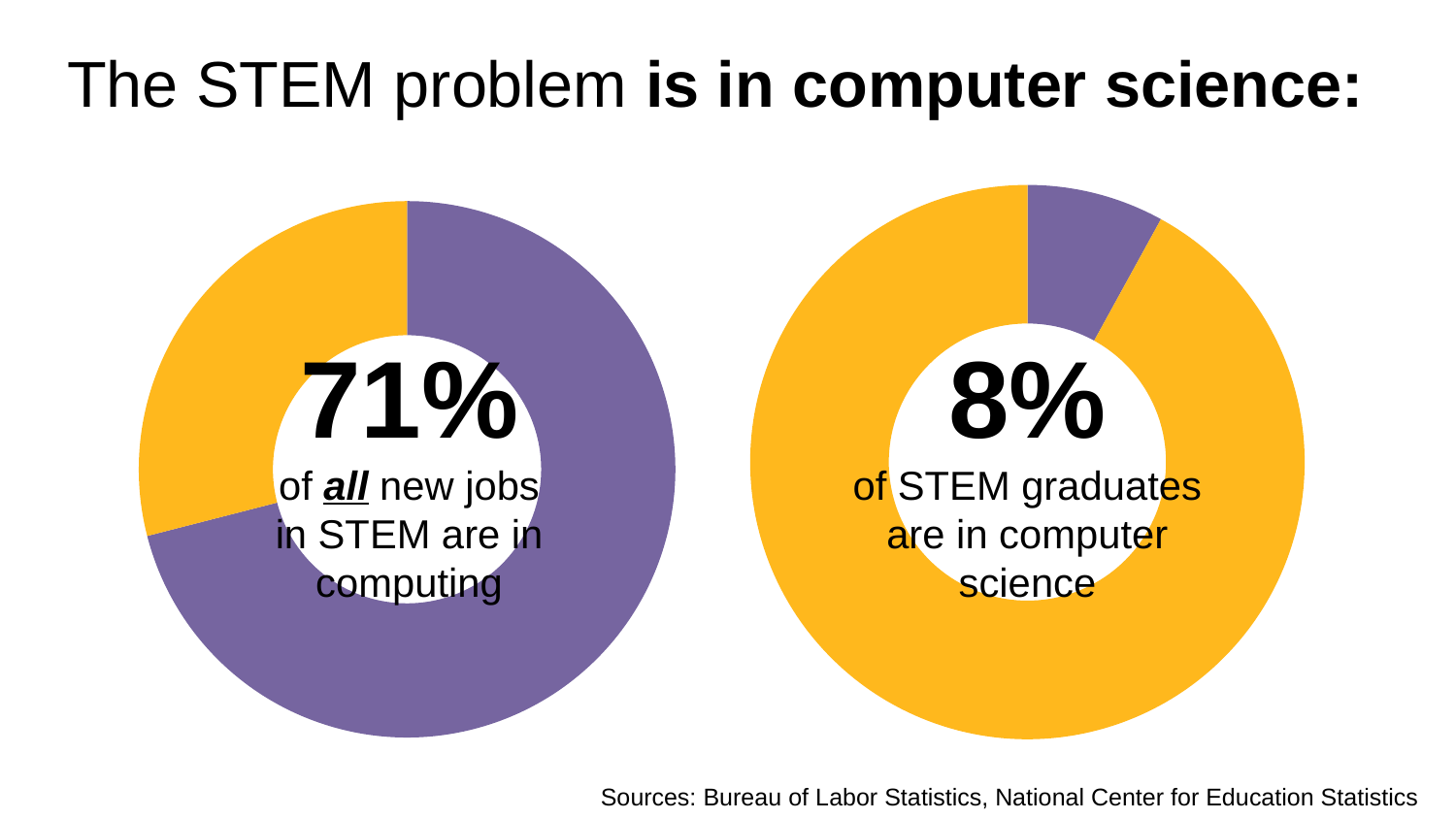
What kind of chart is used on the right side of the slide? Donut (pie) chart What is the difference in percentage points between the 71% in the left chart and the 8% in the right chart? 63 percentage points In the right chart, what percentage of STEM graduates are in computer science? 8% In the right chart, is the highlighted purple slice greater or less than 25% of the donut? less In the left chart, what percentage of all new jobs in STEM are in computing? 71% In the left chart, is the highlighted purple slice greater or less than 50% of the donut? greater What kind of chart is used on the left side of the slide? Donut (pie) chart Which is larger: the share of new STEM jobs in computing (left chart) or the share of STEM graduates in computer science (right chart)? Share of new STEM jobs in computing (left chart) In the left chart, what share of the donut is not in computing (the yellow portion)? 29% What is the title of the slide? The STEM problem is in computer science: How many charts are shown on the slide? 2 In the right chart, what share of STEM graduates are not in computer science (the yellow portion)? 92%